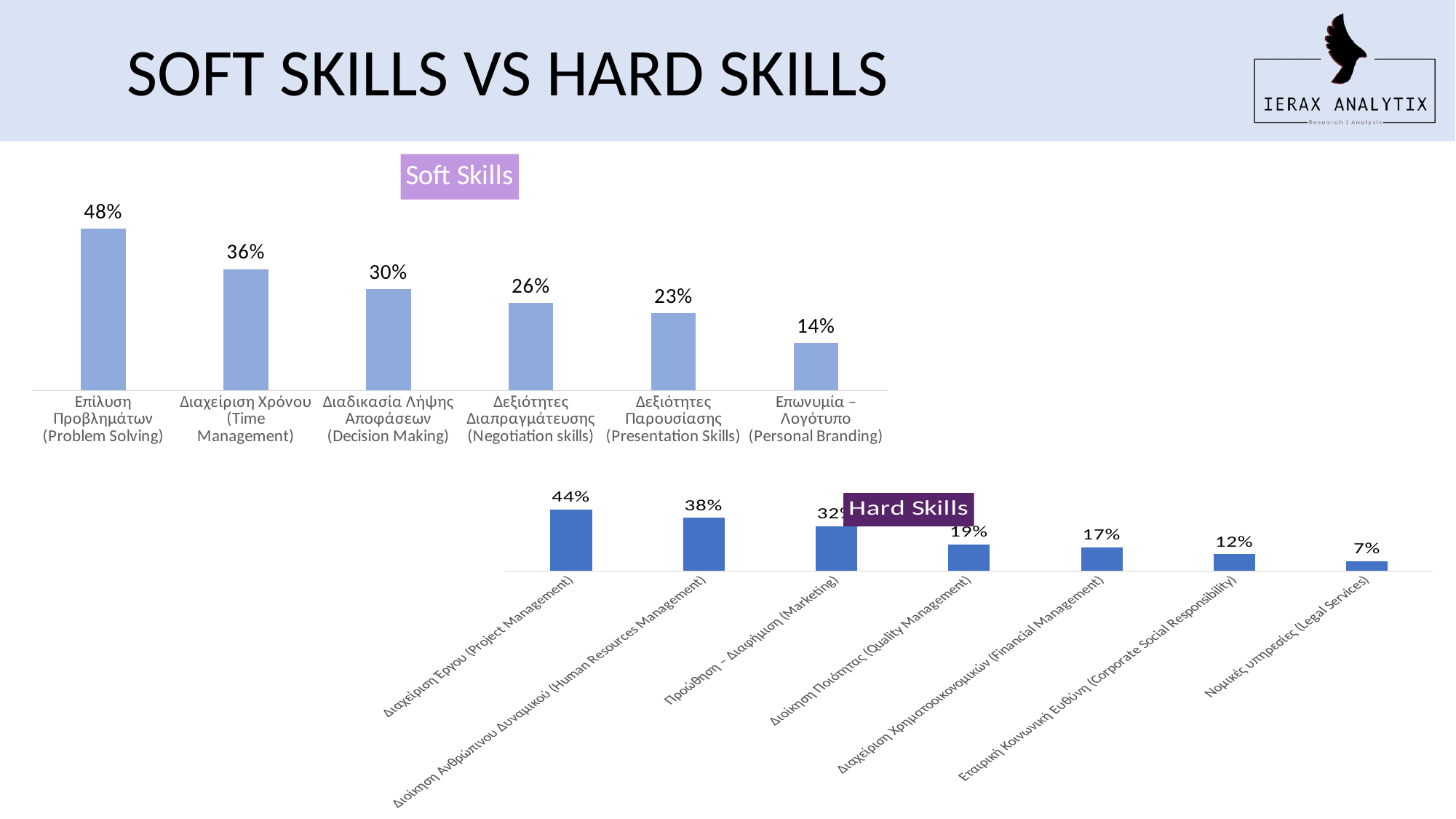
In the Soft Skills chart, what is the difference between Time Management and Presentation Skills? 13% In the Hard Skills chart, how many categories are shown? 7 In the Hard Skills chart, which is larger: Quality Management or Financial Management? Quality Management In the Soft Skills chart, which category has the lowest value? Personal Branding In the Hard Skills chart, which category has the highest value? Project Management In the Soft Skills chart, do the values rise or fall from left to right? fall In the Soft Skills chart, how many categories are shown? 6 In the Soft Skills chart, what is the value for Negotiation skills? 26% In the Soft Skills chart, what is the value for Problem Solving? 48% In the Hard Skills chart, what is the value for Legal Services? 7% In the Hard Skills chart, what is the value for Project Management? 44% What type of chart is the Hard Skills chart? bar chart